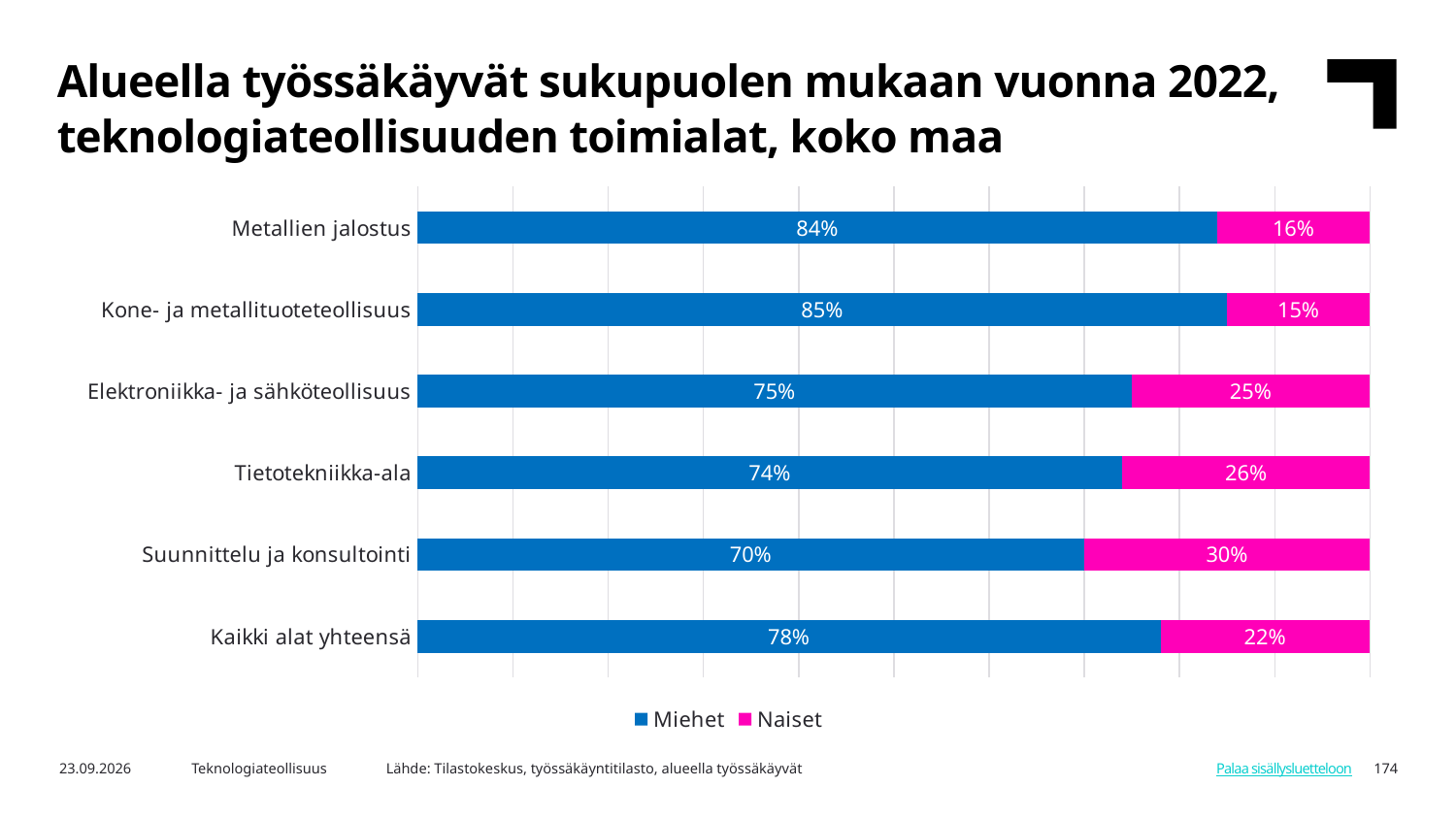
What is the Naiset share for Suunnittelu ja konsultointi? 30% What is the Miehet share for Kaikki alat yhteensä? 78% Which is larger: the Naiset share for Elektroniikka- ja sähköteollisuus or for Kaikki alat yhteensä? Elektroniikka- ja sähköteollisuus Which category has the lowest Miehet share? Suunnittelu ja konsultointi How many series does the legend list? 2 What is the difference between the Naiset share for Suunnittelu ja konsultointi and for Metallien jalostus? 14 percentage points What kind of chart is shown on the slide? Stacked bar chart Which category has the highest Miehet share? Kone- ja metallituoteteollisuus How many categories are shown on the chart? 6 Which category has the highest Naiset share? Suunnittelu ja konsultointi What is the Naiset share for Tietotekniikka-ala? 26% What is the Miehet share for Metallien jalostus? 84%